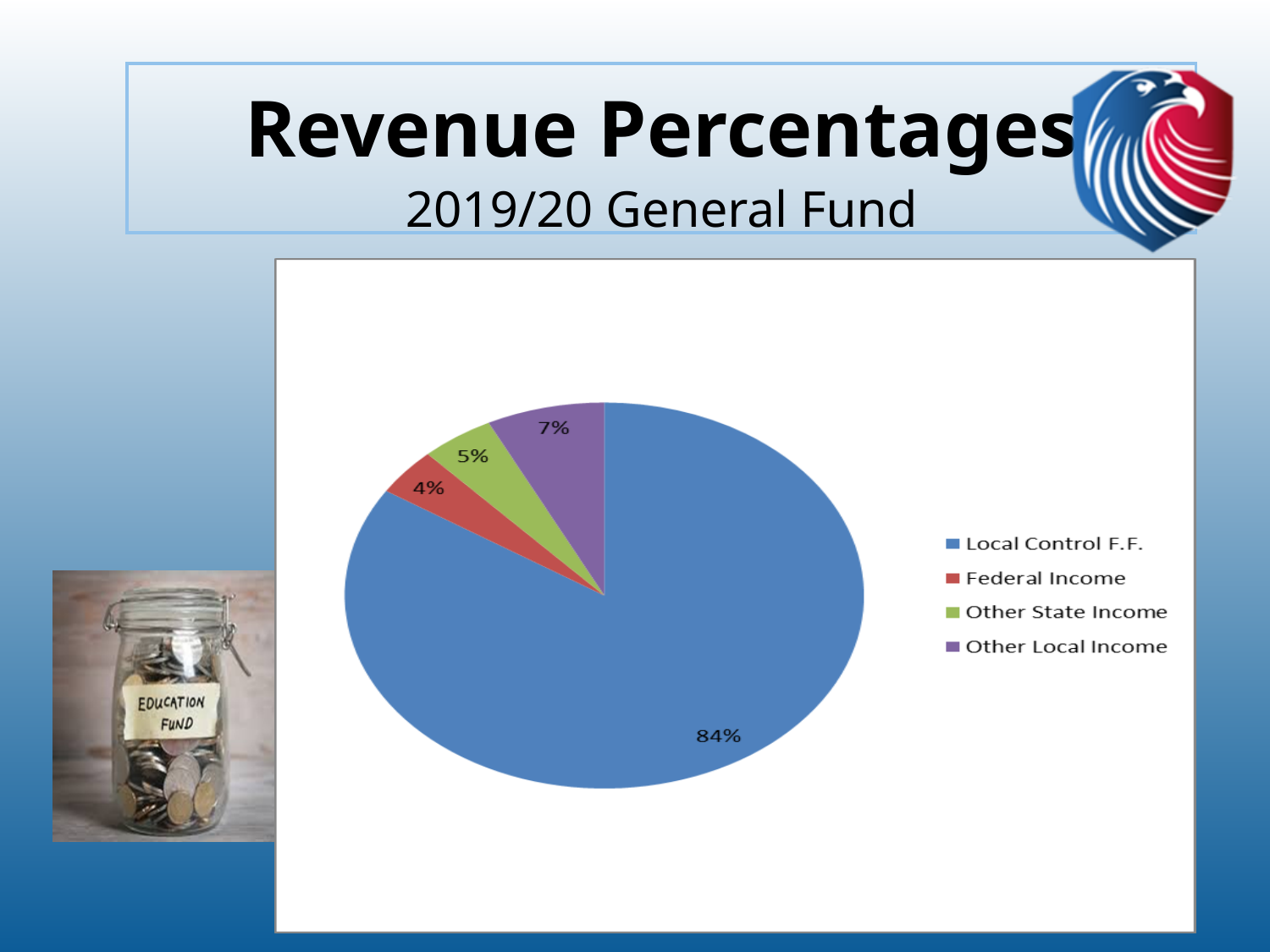
Which is larger, the share for Other State Income or the share for Other Local Income? Other Local Income What percentage of revenue comes from Other State Income? 5% What kind of chart is shown on the slide? pie chart What percentage of revenue comes from Other Local Income? 7% What colour is the Other State Income slice? green How many slices does the pie chart have? 4 What is the difference in percentage points between Other Local Income and Federal Income? 3 What percentage of the 2019/20 General Fund revenue comes from Local Control F.F.? 84% How many entries does the legend list? 4 Which revenue source has the largest share of the pie? Local Control F.F. Which revenue source has the smallest share of the pie? Federal Income What percentage of revenue comes from Federal Income? 4%